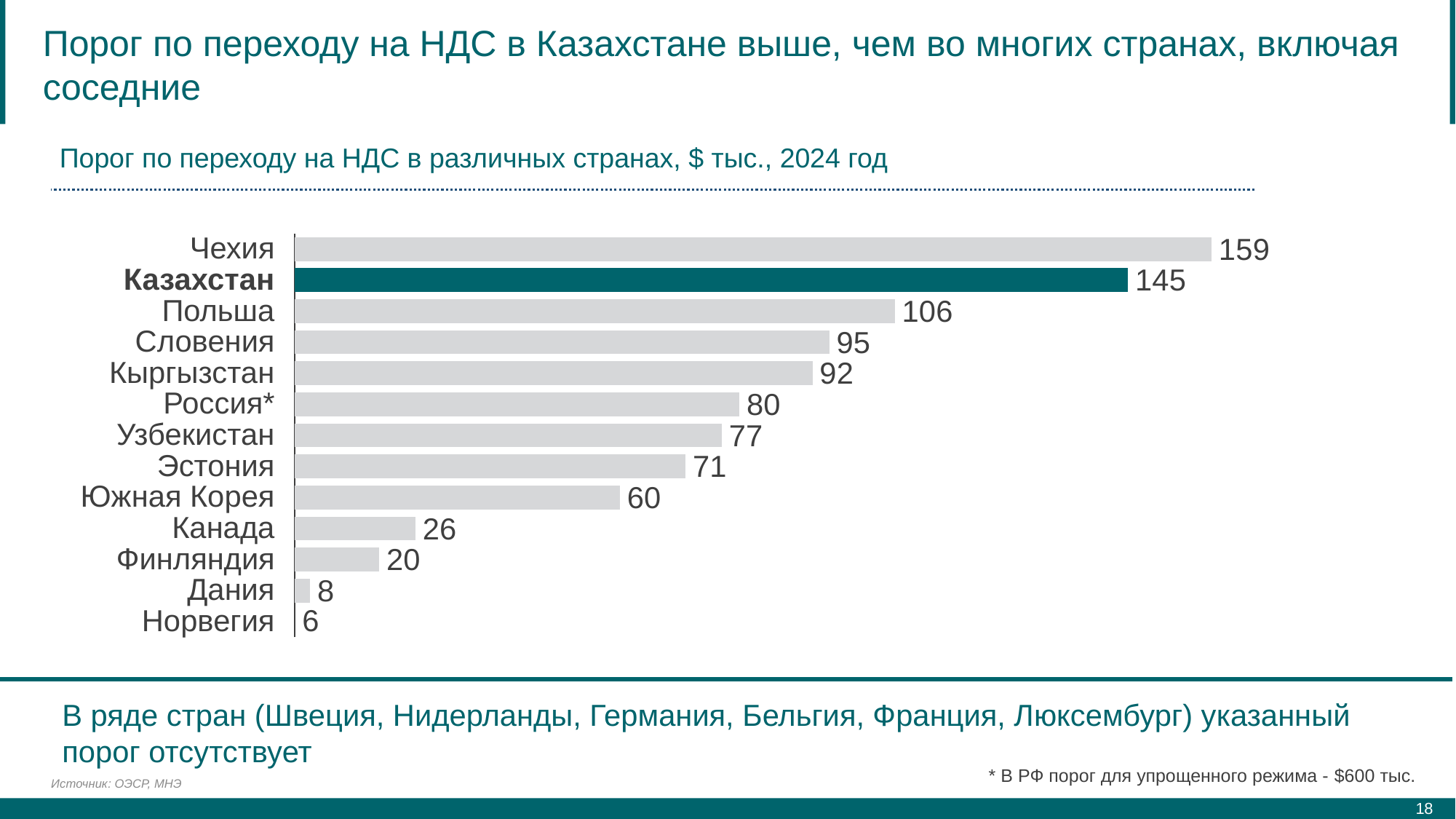
Which country's bar is highlighted in a dark teal colour, unlike the grey bars? Казахстан What value is shown for Финляндия? 20 Which has a larger value, Польша or Словения? Польша What value is shown for Кыргызстан? 92 Which has a larger value, Канада or Южная Корея? Южная Корея How many countries are shown on the chart? 13 Which country has the lowest threshold on the chart? Норвегия What is the difference between the values for Чехия and Казахстан? 14 What is the VAT registration threshold shown for Казахстан? 145 Which country has the highest threshold on the chart? Чехия What is the difference between the values for Казахстан and Россия*? 65 What type of chart is shown on the slide? Bar chart